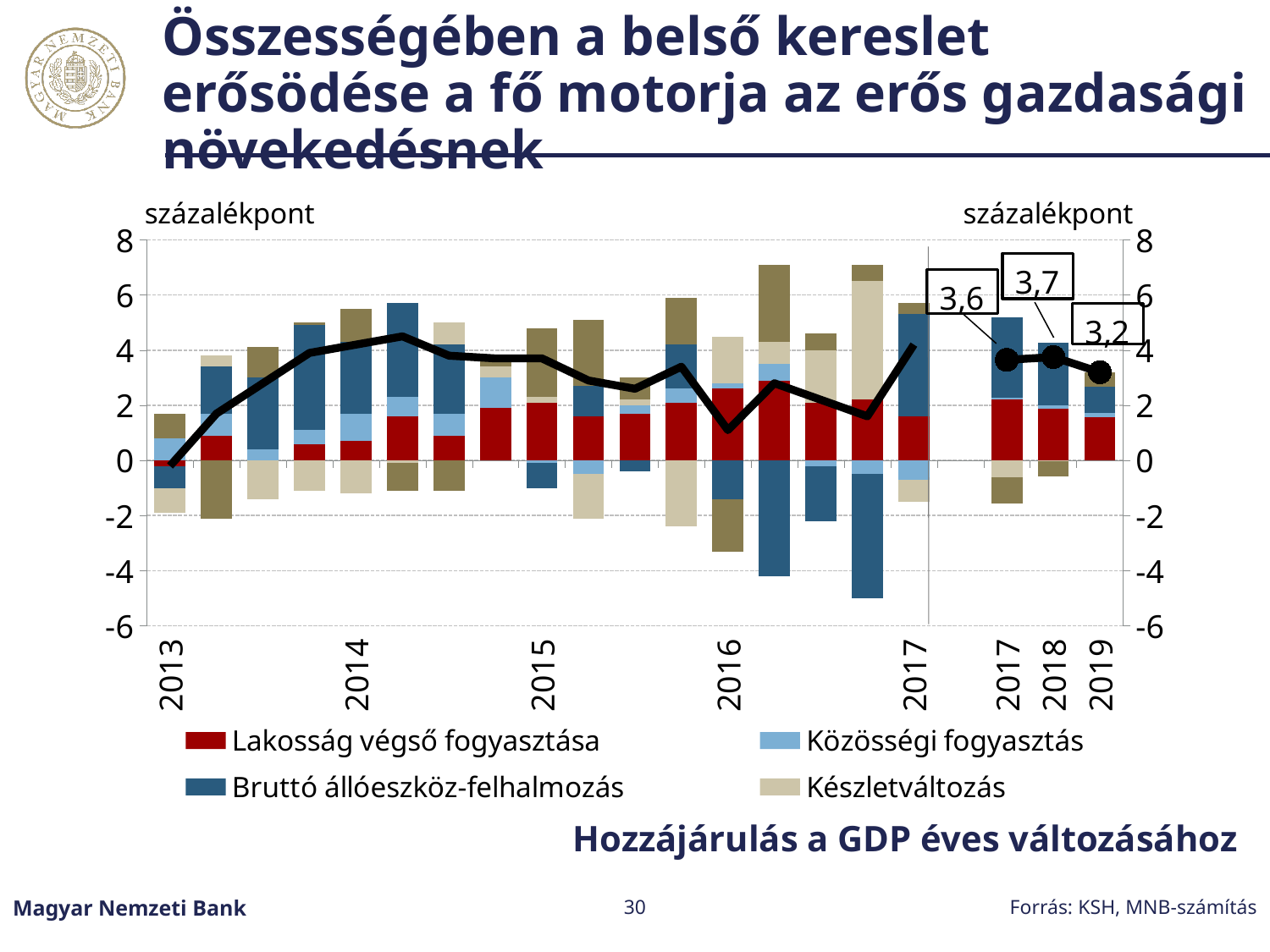
What is the difference between the labelled GDP growth values for 2018 and 2019? 0,5 Among the three labelled forecast years (2017, 2018, 2019), which has the lowest GDP growth value? 2019 What is the labelled value of the GDP growth line for 2017 in the forecast section on the right? 3,6 What is the labelled value of the GDP growth line for 2018? 3,7 Among the three labelled forecast years (2017, 2018, 2019), which has the highest GDP growth value? 2018 What kind of chart is shown on the slide? Stacked bar chart with a line How many series does the legend list? 4 What unit is shown on the vertical axes of the chart? százalékpont What is the labelled value of the GDP growth line for 2019? 3,2 Is the value of the black line at the first quarter of 2016 greater or less than 2? less Which is larger, the labelled GDP growth value for 2017 or for 2019? 2017 Does the black line rise or fall between the start of 2013 and the start of 2014? rise